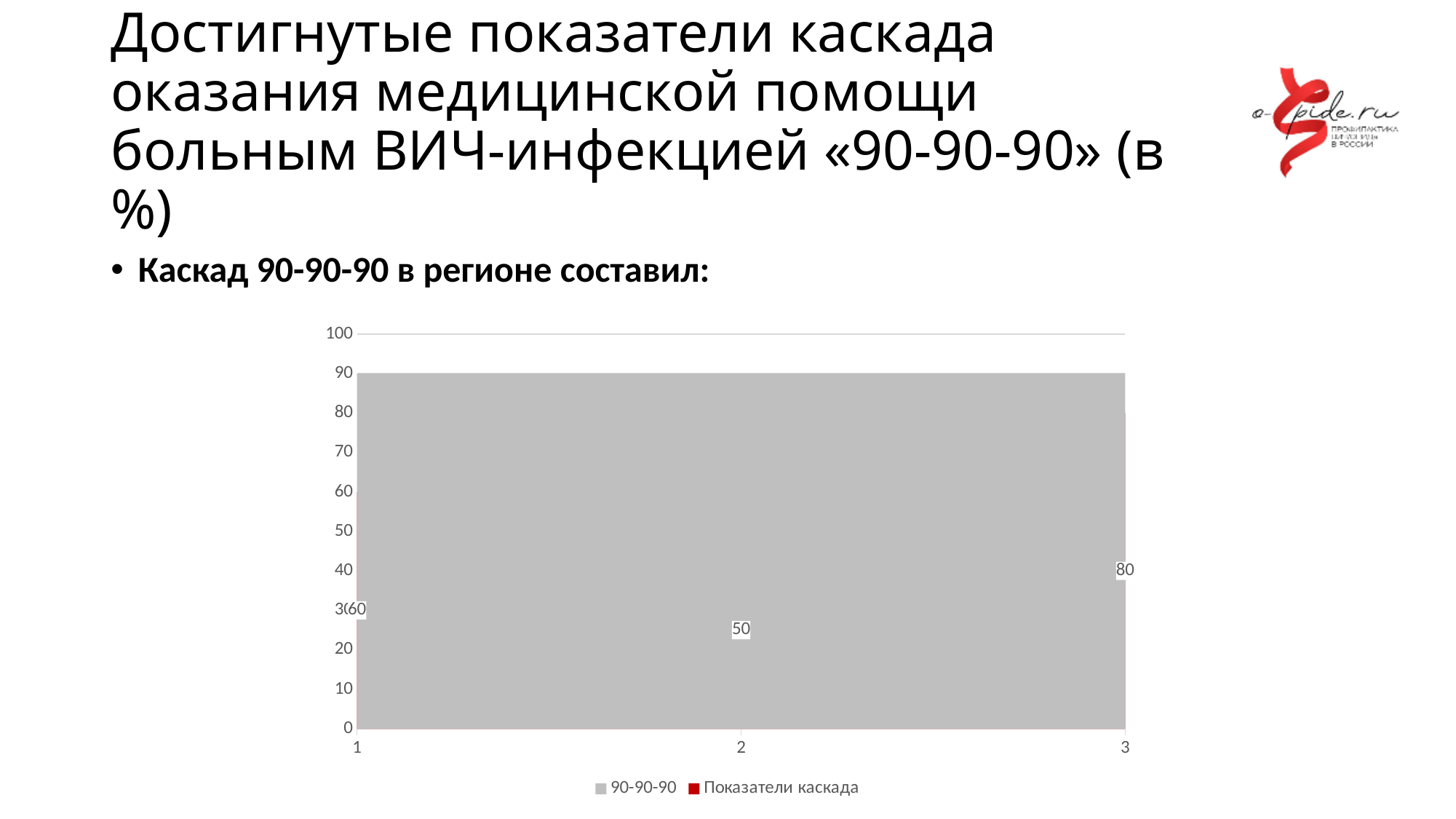
What is the difference between the Показатели каскада values at category 3 and category 2? 30 At which category does the Показатели каскада series have its lowest value? 2 What is the value of the Показатели каскада series at category 3? 80 Is the value of the 90-90-90 series at category 2 greater or less than 50? greater What is the value of the Показатели каскада series at category 2? 50 What colour is used for the 90-90-90 series in the chart? grey At which category does the Показатели каскада series reach its highest value? 3 How many series does the chart legend list? 2 What type of chart is shown on the slide? area chart Which category has the larger Показатели каскада value, 1 or 2? 1 How many categories are shown on the x axis of the chart? 3 What is the value of the Показатели каскада series at category 1? 60